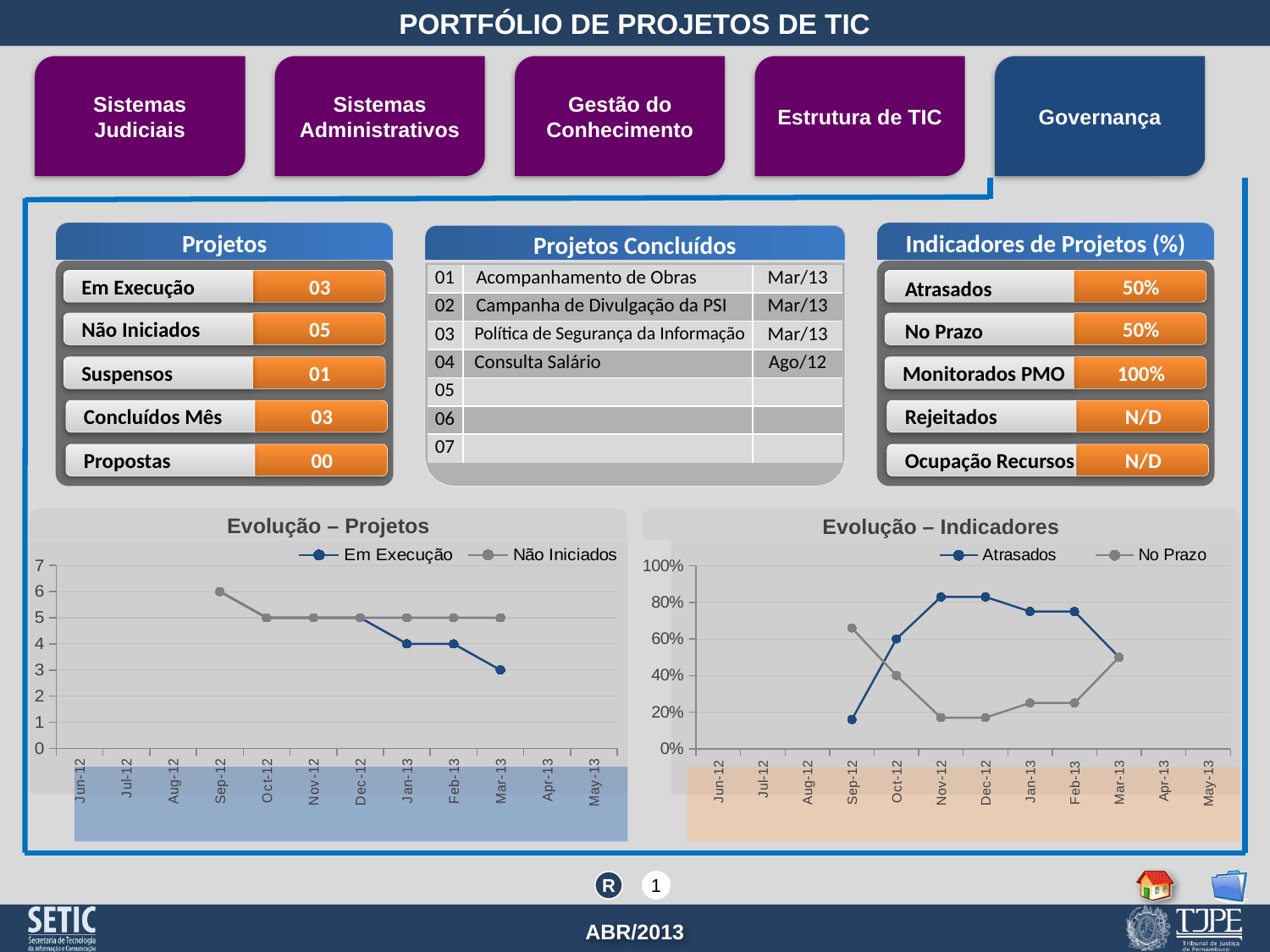
How many series does the legend of the "Evolução – Projetos" chart list? 2 In the "Evolução – Projetos" chart, what is the value of Não Iniciados at Sep-12? 6 In the "Evolução – Projetos" chart, what is the difference between Não Iniciados and Em Execução at Jan-13? 1 In the "Evolução – Indicadores" chart, what is the value of No Prazo at Oct-12? 40% In the "Evolução – Indicadores" chart, is the value for No Prazo at Dec-12 greater or less than 20%? less In the "Evolução – Projetos" chart, at which month is Não Iniciados highest? Sep-12 In the "Evolução – Indicadores" chart, is the value for Atrasados at Nov-12 greater or less than 80%? greater In the "Evolução – Indicadores" chart, which series is larger at Jan-13, Atrasados or No Prazo? Atrasados In the "Evolução – Projetos" chart, does the Em Execução series rise or fall from Dec-12 to Mar-13? Fall In the "Evolução – Indicadores" chart, what is the value of Atrasados at Oct-12? 60% What kind of chart is the "Evolução – Projetos" chart? Line chart In the "Evolução – Projetos" chart, what is the value of Em Execução at Mar-13? 3